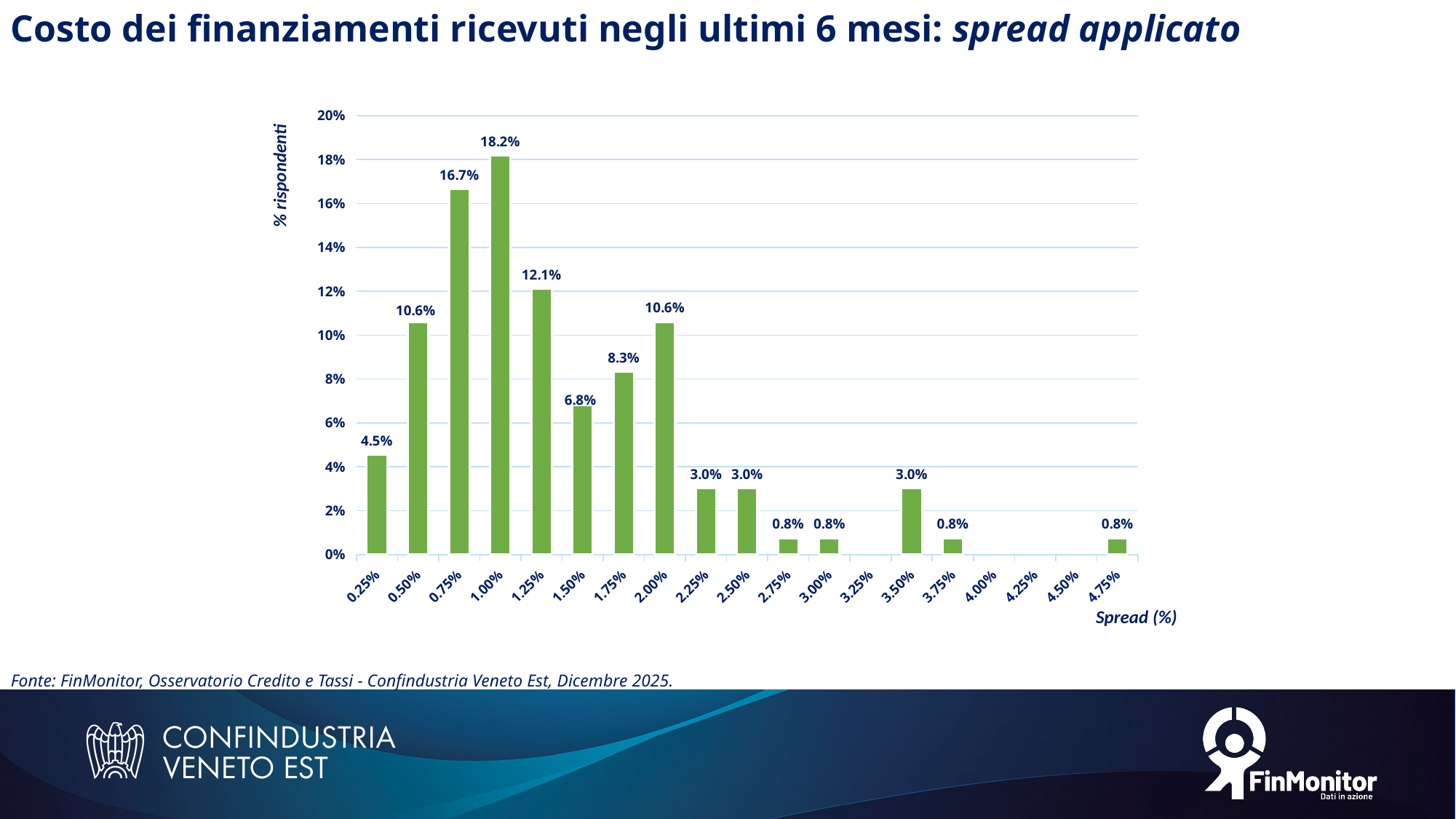
What value is shown for the 4.75% spread category? 0.8% What is the value shown for the 0.75% spread category? 16.7% How many spread categories are labelled on the x axis? 19 What type of chart is shown on the slide? Bar chart What is the label of the y axis? % rispondenti What is the difference between the values for the 1.25% and 2.00% spread categories? 1.5% What is the difference between the values for the 1.00% and 0.75% spread categories? 1.5% Which has a higher percentage of respondents: the 1.75% spread or the 1.50% spread? 1.75% What percentage of respondents reported a spread of 1.00%? 18.2% Do the values rise or fall from the 1.00% spread category to the 1.50% spread category? Fall What percentage of respondents is shown for the 1.50% spread? 6.8% Which spread category has the highest percentage of respondents? 1.00%